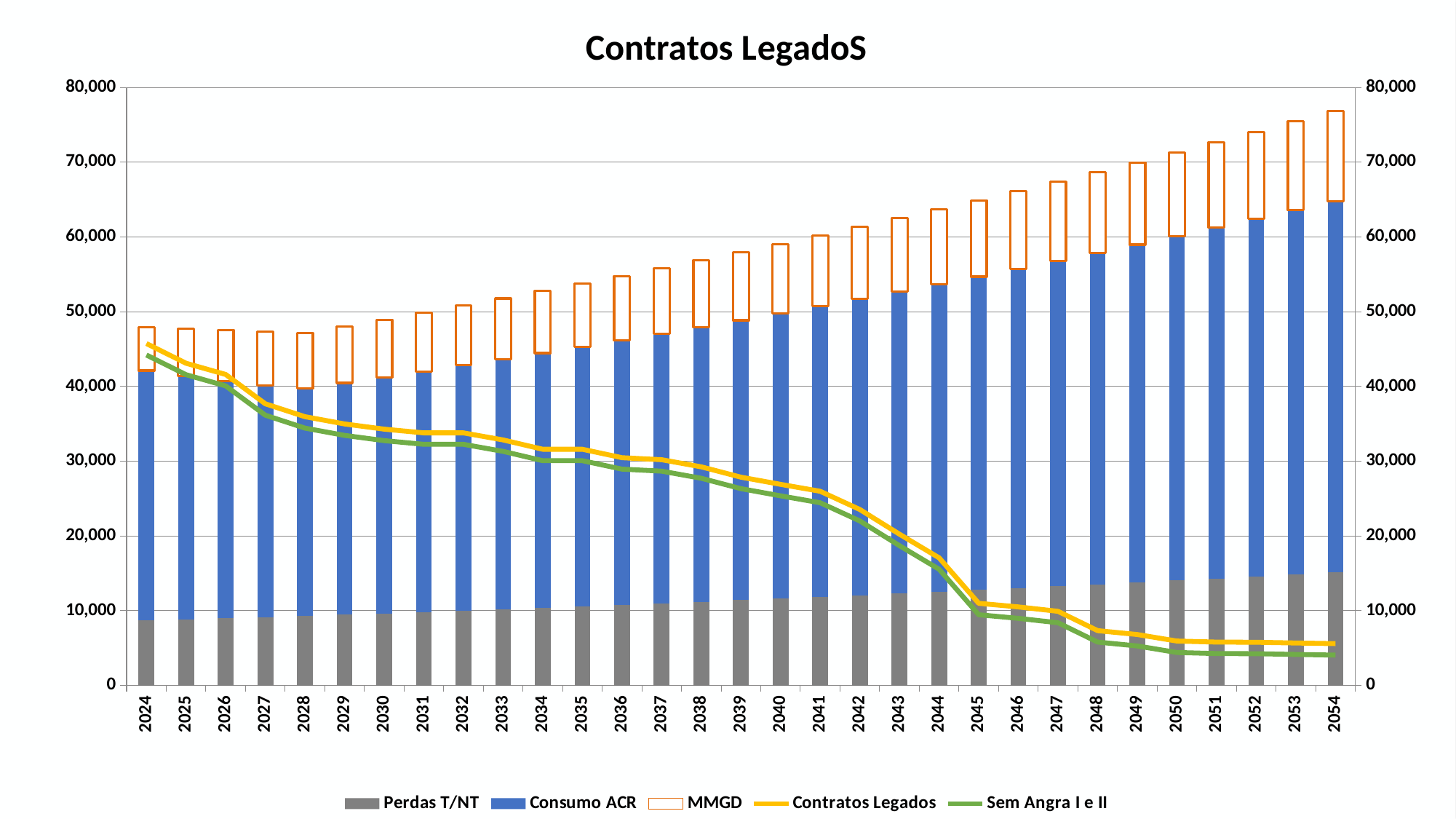
Is the value of the Contratos Legados line in 2024 greater or less than 40,000? greater Does the Contratos Legados line rise or fall from 2024 to 2054? fall How many years are shown on the x axis? 31 Is the total height of the stacked bar for 2054 greater or less than 70,000? greater How many series does the legend list? 5 Is the value of the Contratos Legados line in 2054 greater or less than 10,000? less Which year has the tallest stacked bar? 2054 In 2040, which line is higher: Contratos Legados or Sem Angra I e II? Contratos Legados What is the title of the chart? Contratos LegadoS What kind of chart is this? Combined stacked bar and line chart